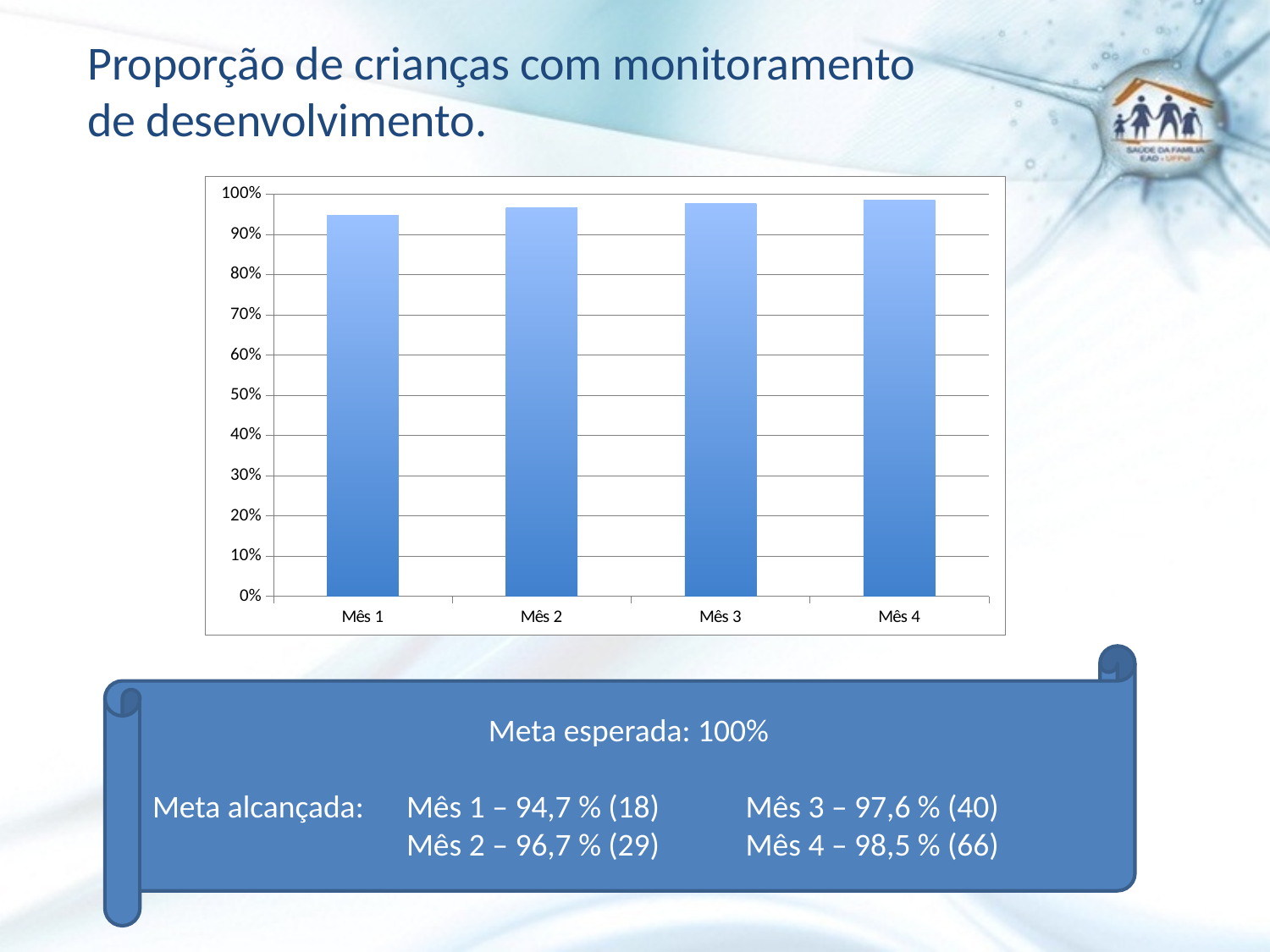
Is the value for Mês 1 greater or less than 90%? greater Is the value for Mês 4 greater or less than 100%? less Which is larger, the value for Mês 2 or the value for Mês 3? Mês 3 Which month has the lowest proportion of children with development monitoring? Mês 1 What is the difference in percentage points between Mês 4 (98,5 %) and Mês 1 (94,7 %)? 3,8 Do the values rise or fall from Mês 1 to Mês 4? rise Which month has the highest proportion of children with development monitoring? Mês 4 According to the slide, what proportion was reached in Mês 4? 98,5 % What kind of chart is shown on the slide? bar chart According to the slide, what proportion was reached in Mês 1? 94,7 % What is the expected target (meta esperada) stated on the slide? 100% How many months (categories) are plotted on the chart? 4